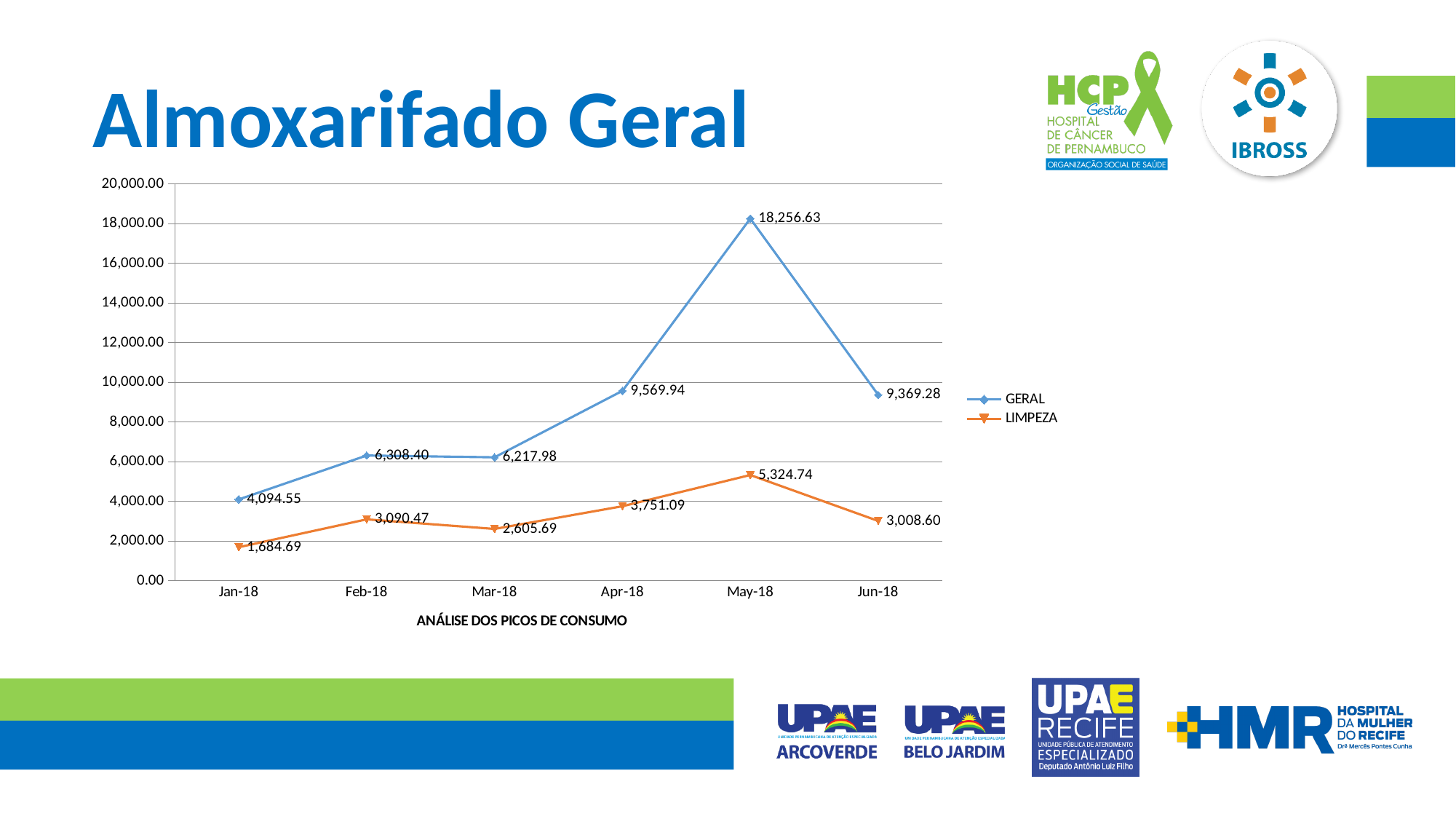
What is the GERAL value for Apr-18? 9,569.94 In which month is the LIMPEZA series at its lowest value? Jan-18 How many months are plotted on the x axis? 6 In which month does the GERAL series reach its highest value? May-18 Which is larger, the GERAL value for Feb-18 or the GERAL value for Mar-18? Feb-18 What is the difference between the GERAL and LIMPEZA values in May-18? 12,931.89 What is the LIMPEZA value for Jan-18? 1,684.69 What is the LIMPEZA value for Jun-18? 3,008.60 What is the GERAL value for May-18? 18,256.63 What kind of chart is shown on the slide? Line chart How many series does the legend list? 2 What is the x-axis title of the chart? ANÁLISE DOS PICOS DE CONSUMO